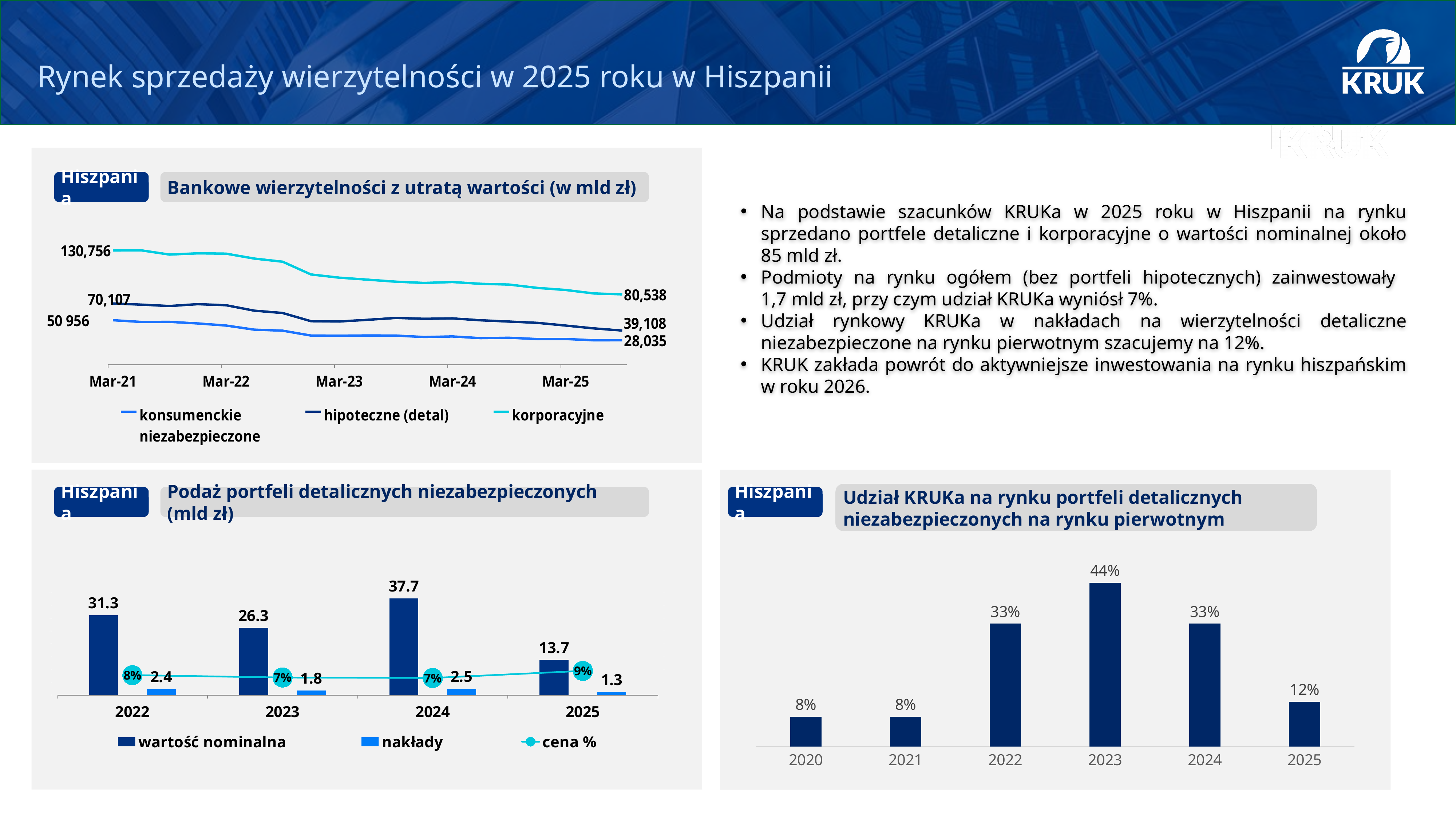
In the chart 'Udział KRUKa na rynku portfeli detalicznych niezabezpieczonych na rynku pierwotnym', which year has the lowest value? 2020 and 2021 (8%) In the chart 'Podaż portfeli detalicznych niezabezpieczonych (mld zł)', how many series does the legend list? 3 In the chart 'Udział KRUKa na rynku portfeli detalicznych niezabezpieczonych na rynku pierwotnym', what is the value for 2023? 44% In the chart 'Udział KRUKa na rynku portfeli detalicznych niezabezpieczonych na rynku pierwotnym', how many years are shown? 6 In the chart 'Podaż portfeli detalicznych niezabezpieczonych (mld zł)', which year has the highest wartość nominalna? 2024 In the chart 'Podaż portfeli detalicznych niezabezpieczonych (mld zł)', what is the wartość nominalna for 2024? 37.7 In the chart 'Udział KRUKa na rynku portfeli detalicznych niezabezpieczonych na rynku pierwotnym', what is the difference between the 2023 and 2025 values? 32 percentage points In the chart 'Bankowe wierzytelności z utratą wartości (w mld zł)', what kind of chart is it? Line chart In the chart 'Podaż portfeli detalicznych niezabezpieczonych (mld zł)', what is the cena % for 2025? 9% In the chart 'Podaż portfeli detalicznych niezabezpieczonych (mld zł)', what is the nakłady value for 2025? 1.3 In the chart 'Bankowe wierzytelności z utratą wartości (w mld zł)', does the hipoteczne (detal) line rise or fall from Mar-21 to Mar-25? Fall